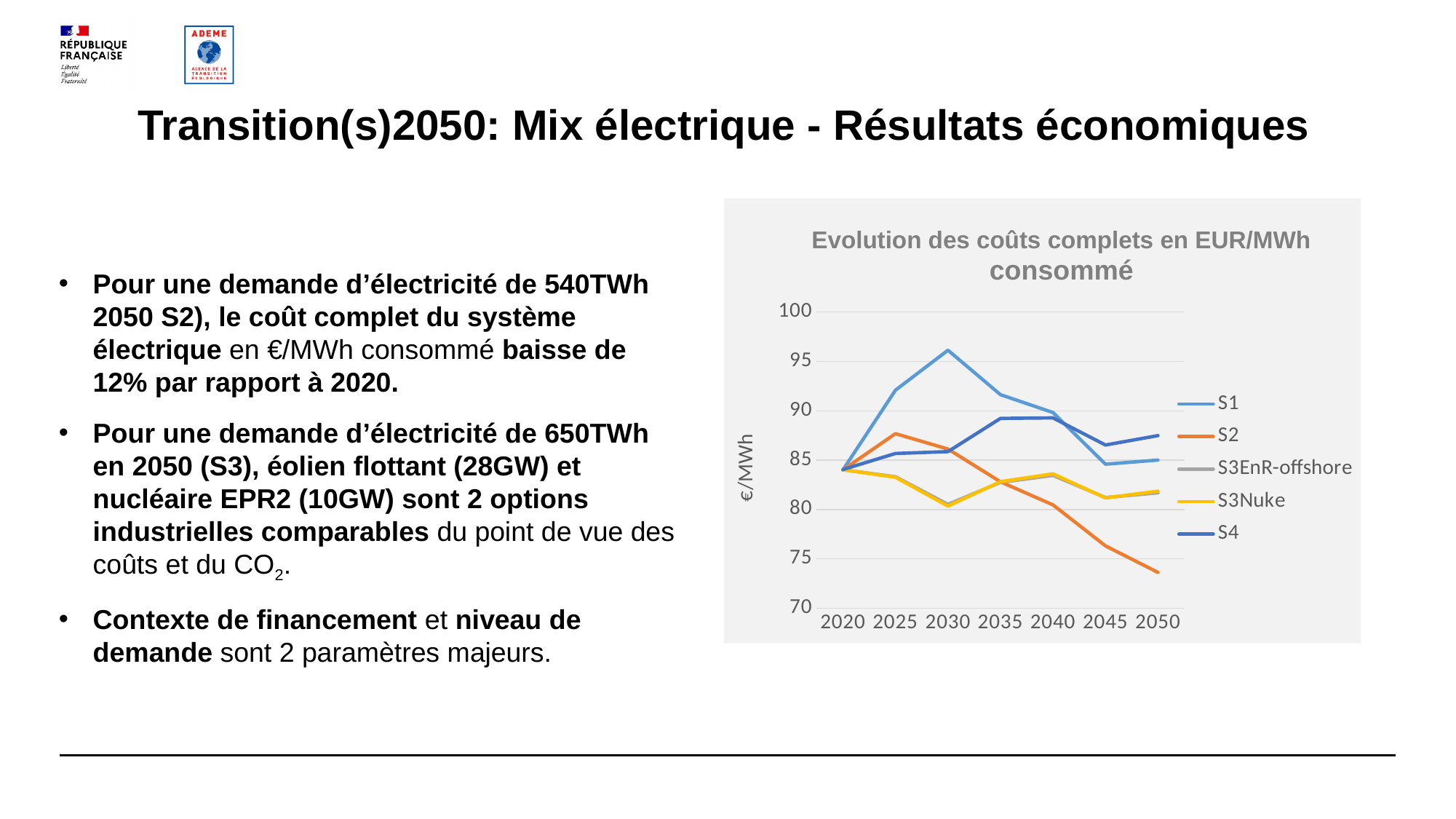
How many series does the legend of the chart list? 5 Does the S2 series rise or fall between 2025 and 2050? fall Is the value for S1 in 2030 greater or less than 90? greater Is the value for S4 in 2035 greater or less than 85? greater In 2050, which series has the larger value, S4 or S1? S4 How many years are shown on the x axis of the chart? 7 Which series has the highest value in 2030? S1 Which series has the lowest value in 2050? S2 What kind of chart is shown on the slide? line chart What is the title of the chart? Evolution des coûts complets en EUR/MWh consommé Is the value for S2 in 2050 greater or less than 75? less What is the label on the y axis of the chart? €/MWh